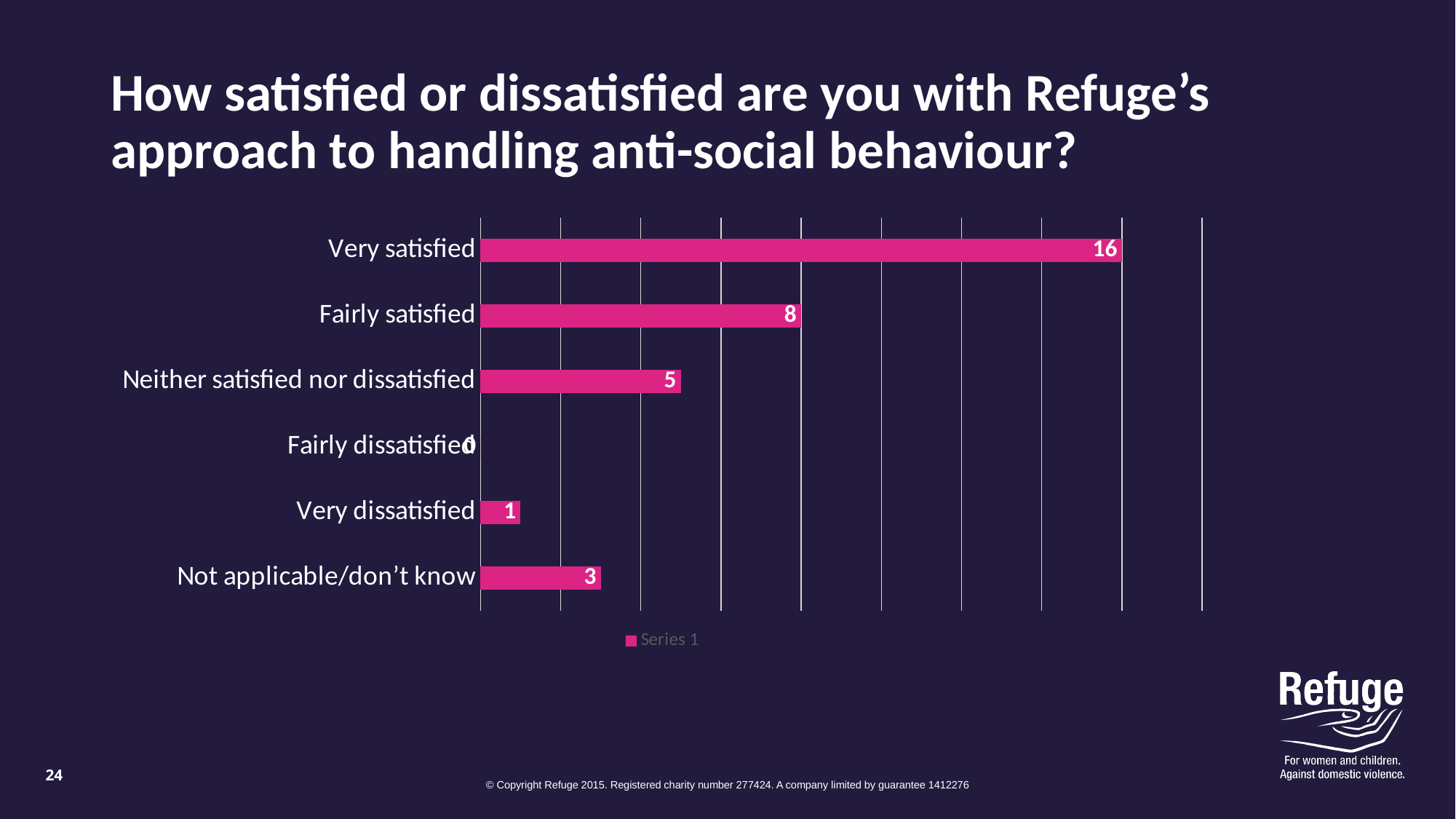
What kind of chart is shown on the slide? Bar chart Which category has the highest value? Very satisfied Which is larger, the value for Neither satisfied nor dissatisfied or the value for Not applicable/don't know? Neither satisfied nor dissatisfied What is the value for Neither satisfied nor dissatisfied? 5 Which category has the lowest value? Fairly dissatisfied What is the name of the series shown in the legend? Series 1 What is the value for Very satisfied? 16 How many categories are shown in the chart? 6 What is the value for Fairly satisfied? 8 What is the difference between the values for Very satisfied and Fairly satisfied? 8 How many series does the legend list? 1 What is the value for Not applicable/don't know? 3